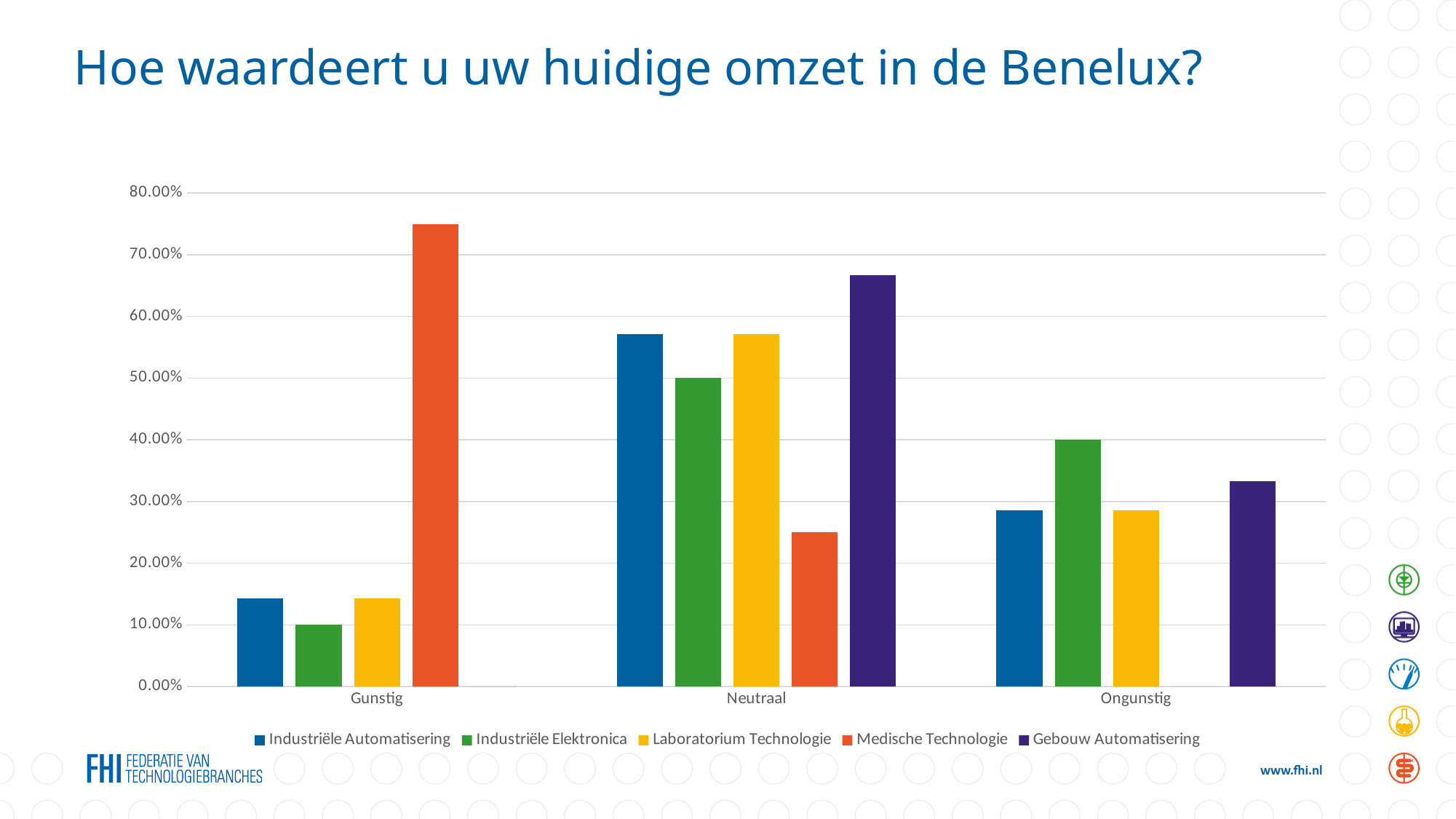
Is the value for Medische Technologie in the Gunstig category greater or less than 70.00%? greater In the Neutraal category, which series has the highest bar? Gebouw Automatisering How many series does the legend list? 5 Is the value for Gebouw Automatisering in the Ongunstig category greater or less than 40.00%? less In the Gunstig category, which series has the highest bar? Medische Technologie What kind of chart is shown on the slide? bar chart In the Neutraal category, which series has the lowest bar? Medische Technologie How many categories are shown on the x axis of the chart? 3 In the Neutraal category, which is larger: Industriële Automatisering or Medische Technologie? Industriële Automatisering What is the title of the slide? Hoe waardeert u uw huidige omzet in de Benelux? In the Ongunstig category, which series has the highest bar? Industriële Elektronica